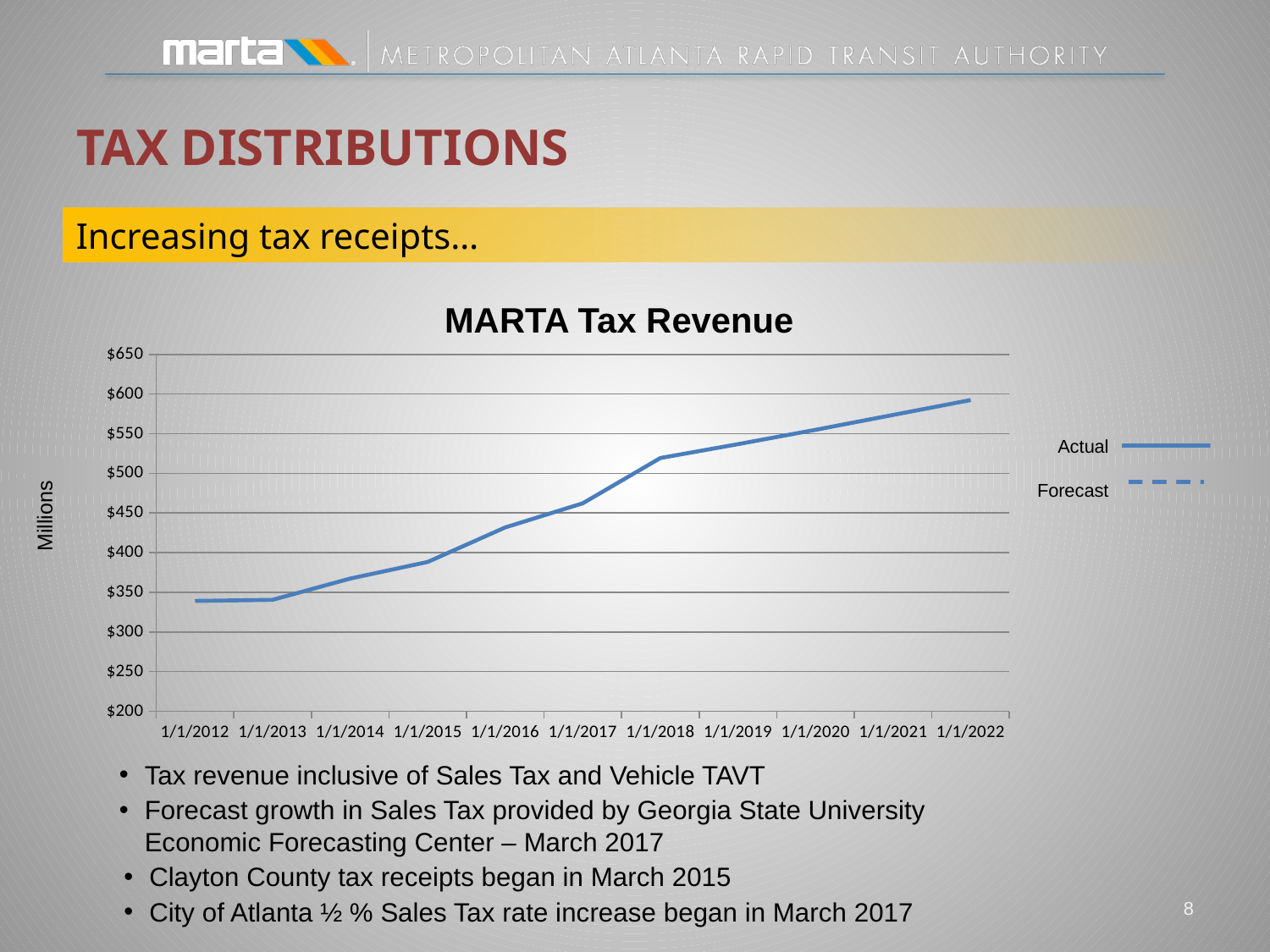
At which date is the tax revenue highest? 1/1/2022 How many dates are labelled along the x axis? 11 Do the values rise or fall from 1/1/2012 to 1/1/2022? Rise What kind of chart is shown on the slide? Line chart Is the value for 1/1/2016 greater or less than $450? less What is the title of the chart? MARTA Tax Revenue Which is larger, the value for 1/1/2015 or the value for 1/1/2019? 1/1/2019 Is the value for 1/1/2012 greater or less than $350? less Is the value for 1/1/2018 greater or less than $500? greater What are the two series named in the legend? Actual and Forecast How many series does the legend list? 2